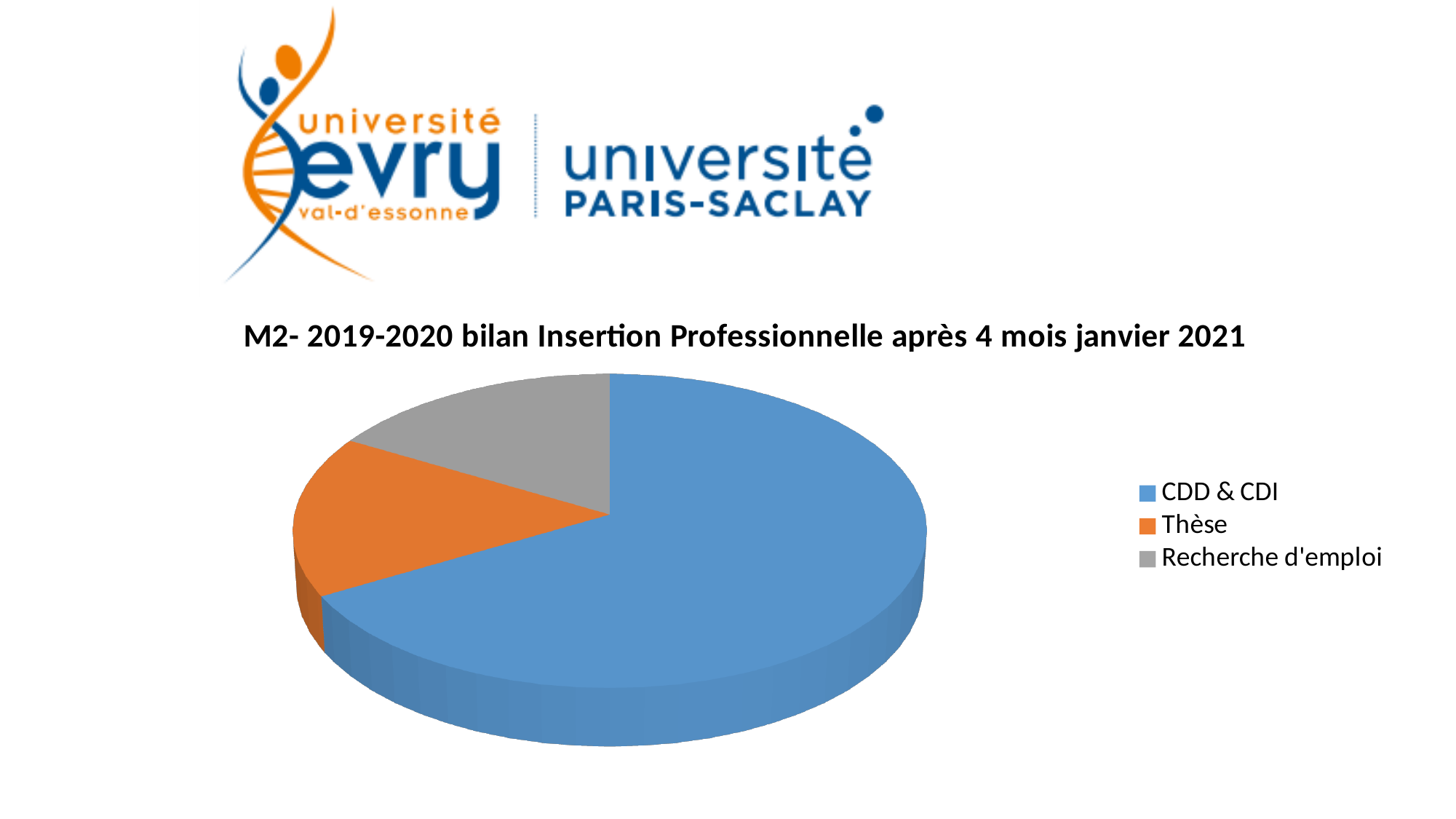
Which slice is larger, CDD & CDI or Thèse? CDD & CDI How many slices does the pie chart have? 3 What kind of chart is shown on the slide? pie chart Which category has the largest slice of the pie chart? CDD & CDI How many entries does the legend of the pie chart list? 3 Which slice is larger, CDD & CDI or Recherche d'emploi? CDD & CDI Is the CDD & CDI slice larger than the Thèse and Recherche d'emploi slices combined? yes Which colour represents Thèse in the pie chart? orange What is the title of the pie chart? M2- 2019-2020 bilan Insertion Professionnelle après 4 mois janvier 2021